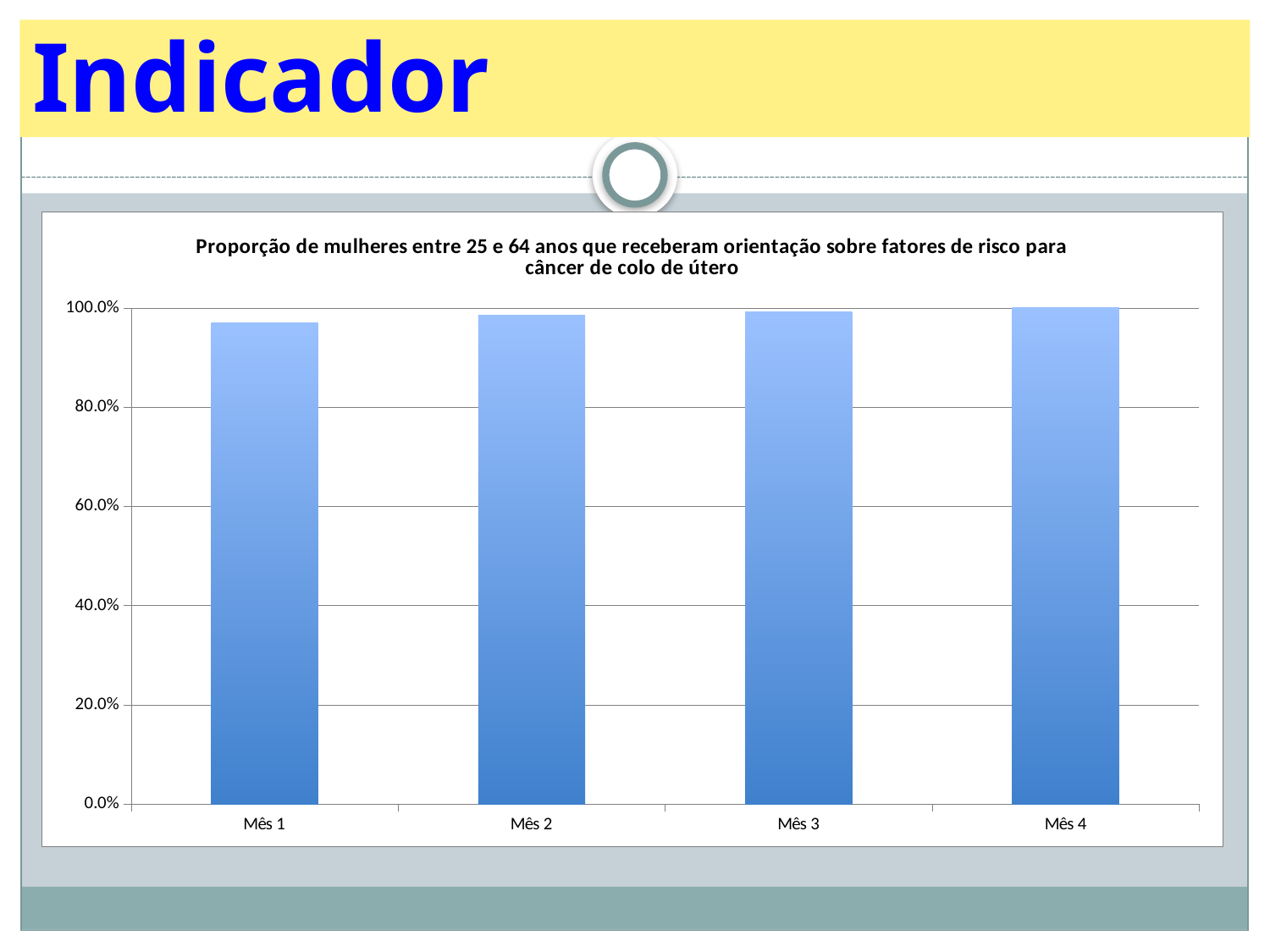
Which is larger, the value for Mês 1 or the value for Mês 4? Mês 4 What kind of chart is shown on the slide? bar chart Is the value for Mês 2 greater or less than 60.0%? greater Do the values rise or fall from Mês 1 to Mês 4? rise What is the title of the chart? Proporção de mulheres entre 25 e 64 anos que receberam orientação sobre fatores de risco para câncer de colo de útero How many categories (months) are shown on the x axis of the chart? 4 What is the highest value shown on the y axis of the chart? 100.0% Is the value for Mês 1 greater or less than 80.0%? greater Which month has the lowest value in the chart? Mês 1 Which month has the highest value in the chart? Mês 4 What is the value for Mês 4? 100.0%